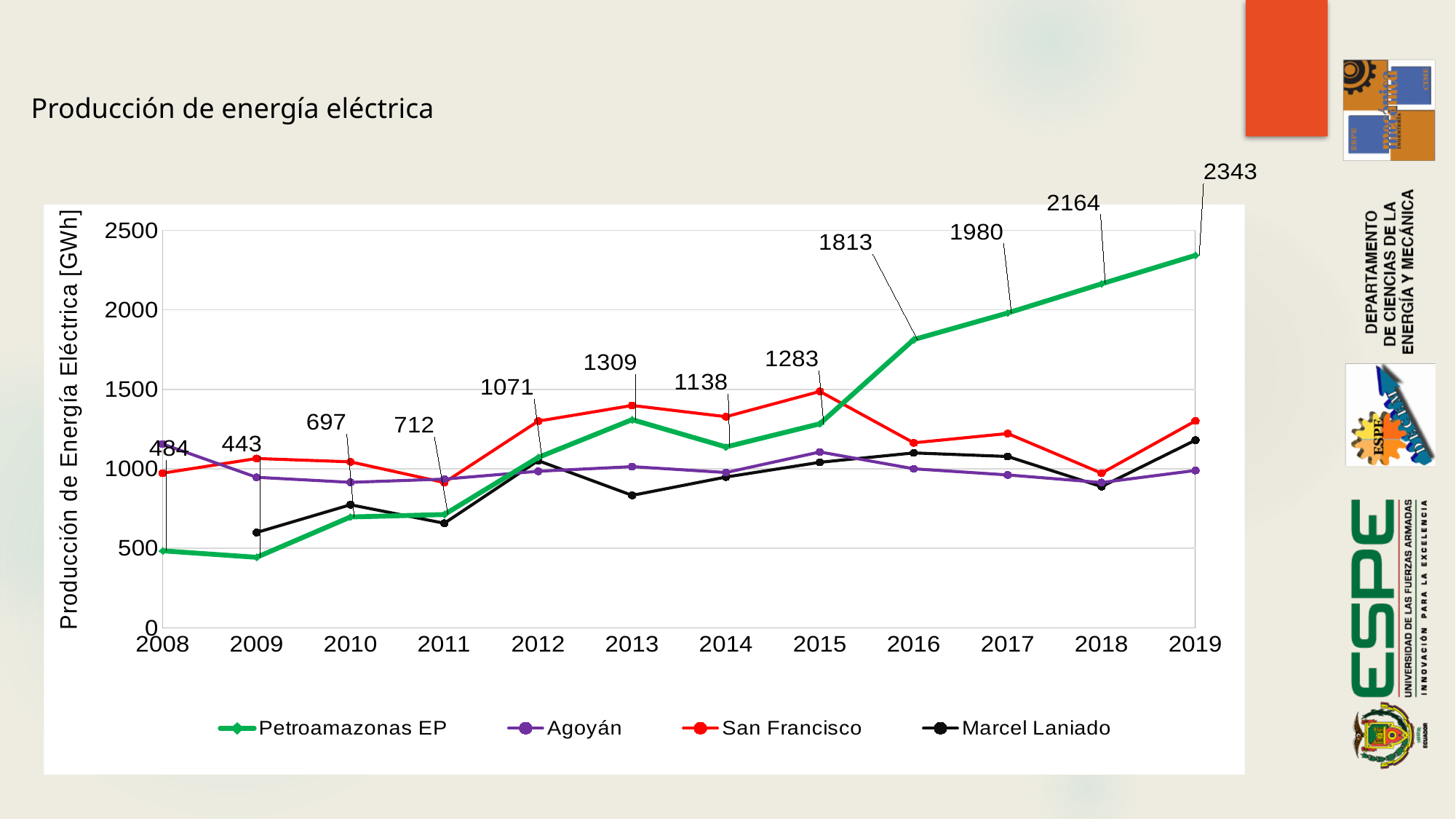
Is the value for San Francisco in 2015 greater or less than 1000? greater How many years are shown on the x axis? 12 Which is larger for Petroamazonas EP, the value in 2013 or the value in 2014? 2013 In which year is the Petroamazonas EP value highest? 2019 What type of chart is shown on the slide? line chart What is the value for Petroamazonas EP in 2019? 2343 What is the difference between the Petroamazonas EP values in 2019 and 2018? 179 How many series does the legend list? 4 What is the value for Petroamazonas EP in 2009? 443 In which year is the Petroamazonas EP value lowest? 2009 What is the value for Petroamazonas EP in 2012? 1071 What is the label of the y axis? Producción de Energía Eléctrica [GWh]